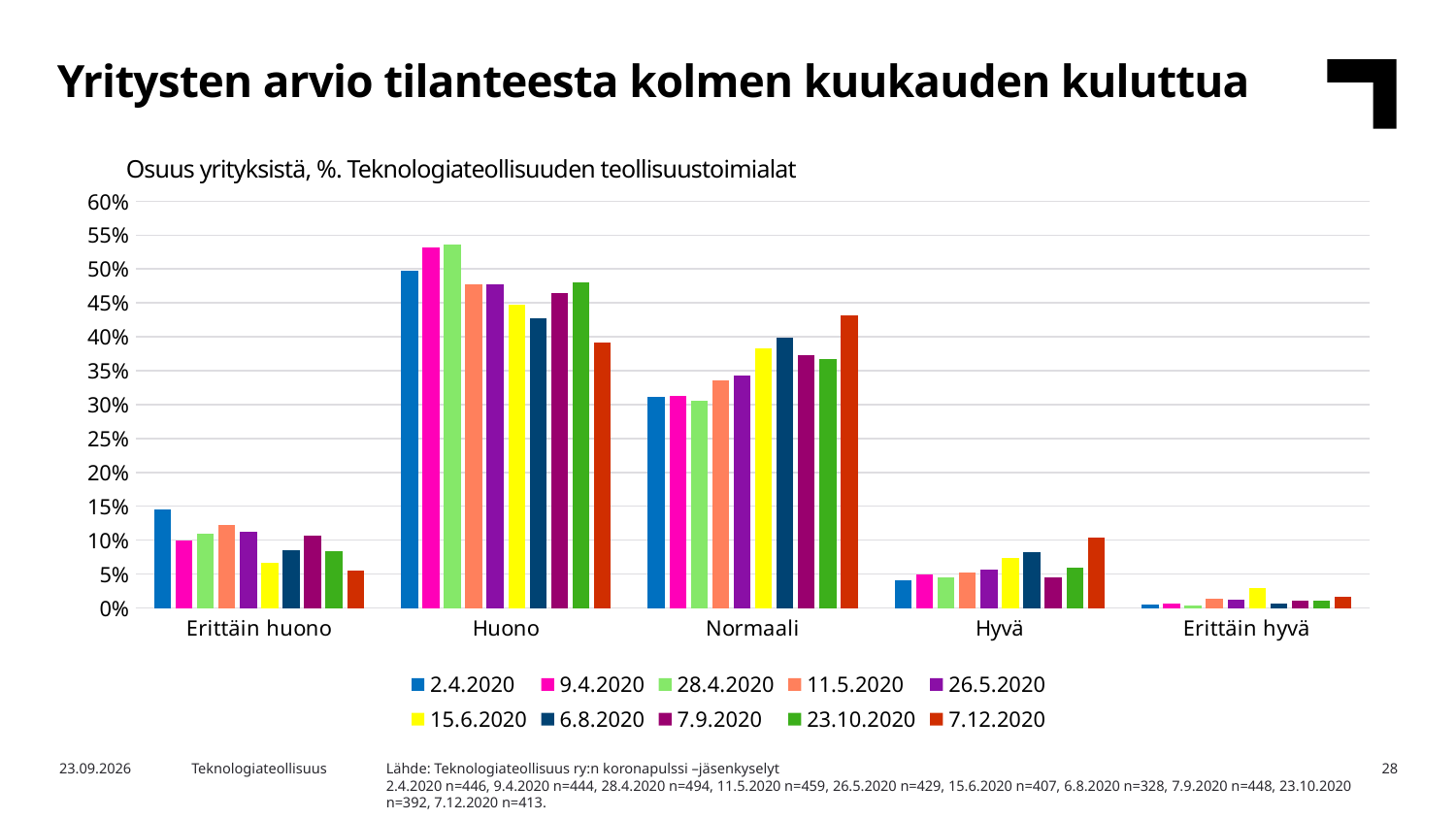
What is the subtitle shown above the chart? Osuus yrityksistä, %. Teknologiateollisuuden teollisuustoimialat For the 7.12.2020 series, which is larger: the value for Huono or the value for Normaali? Normaali Is the value for Huono on 2.4.2020 greater or less than 45%? greater How many categories are shown on the x axis of the chart? 5 Is the value for Erittäin huono on 7.12.2020 greater or less than 10%? less How many series does the legend list? 10 Is the value for Erittäin hyvä on 15.6.2020 greater or less than 5%? less Which category has the highest value for the 7.12.2020 series? Normaali What kind of chart is shown on the slide? bar chart Within the Huono category, which survey date has the lowest value? 7.12.2020 Within the Erittäin huono category, which survey date has the highest value? 2.4.2020